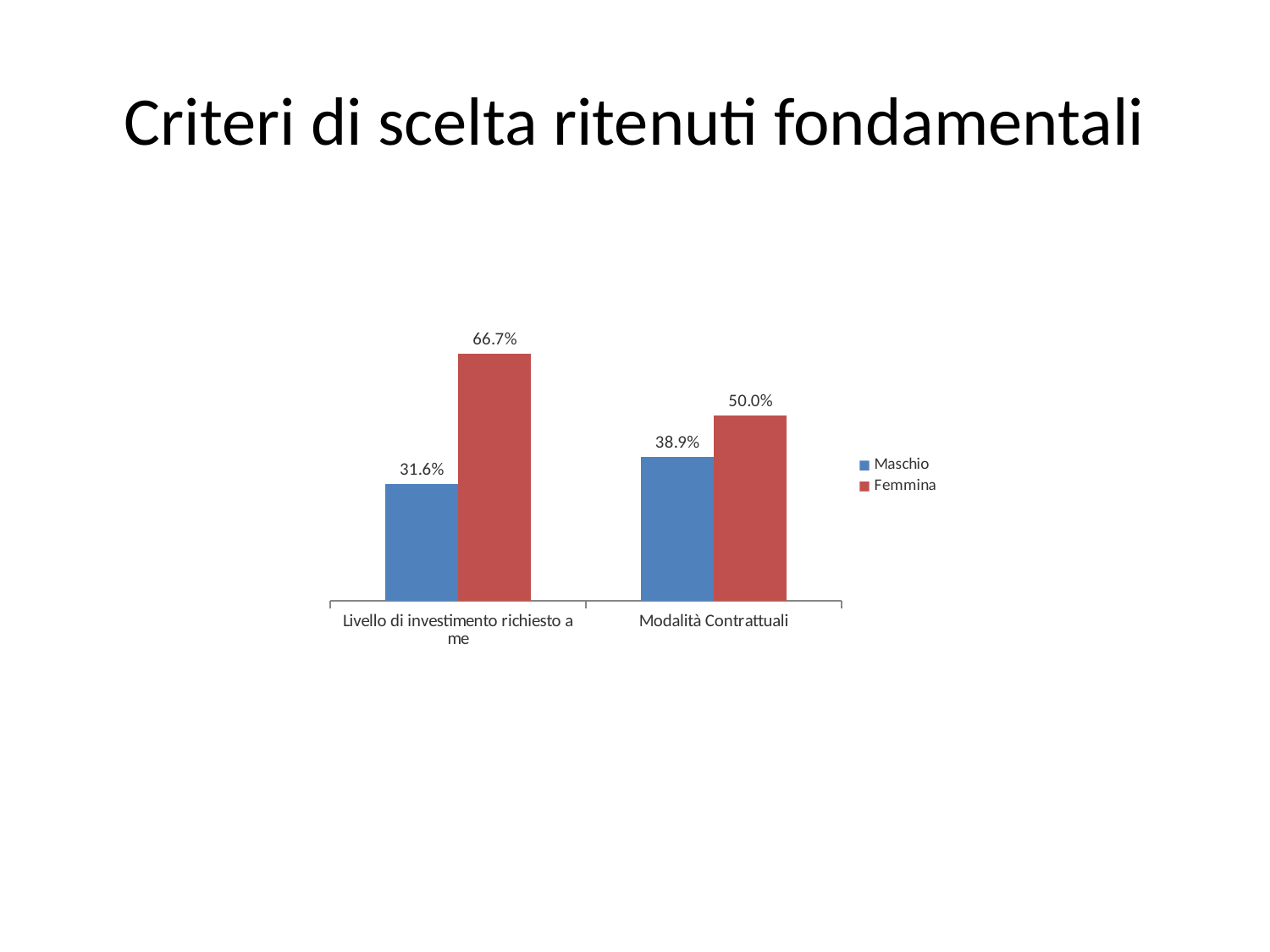
Which category has the lowest Maschio value? Livello di investimento richiesto a me What is the difference between the Femmina and Maschio values for "Modalità Contrattuali"? 11.1% What is the value for Femmina in the category "Livello di investimento richiesto a me"? 66.7% Which is larger for "Modalità Contrattuali": the Maschio value or the Femmina value? Femmina Which category has the highest Femmina value? Livello di investimento richiesto a me What is the value for Femmina in the category "Modalità Contrattuali"? 50.0% How many categories are shown on the x axis? 2 What is the value for Maschio in the category "Modalità Contrattuali"? 38.9% What is the value for Maschio in the category "Livello di investimento richiesto a me"? 31.6% How many series does the legend list? 2 What kind of chart is shown on the slide? Bar chart What is the difference between the Femmina and Maschio values for "Livello di investimento richiesto a me"? 35.1%